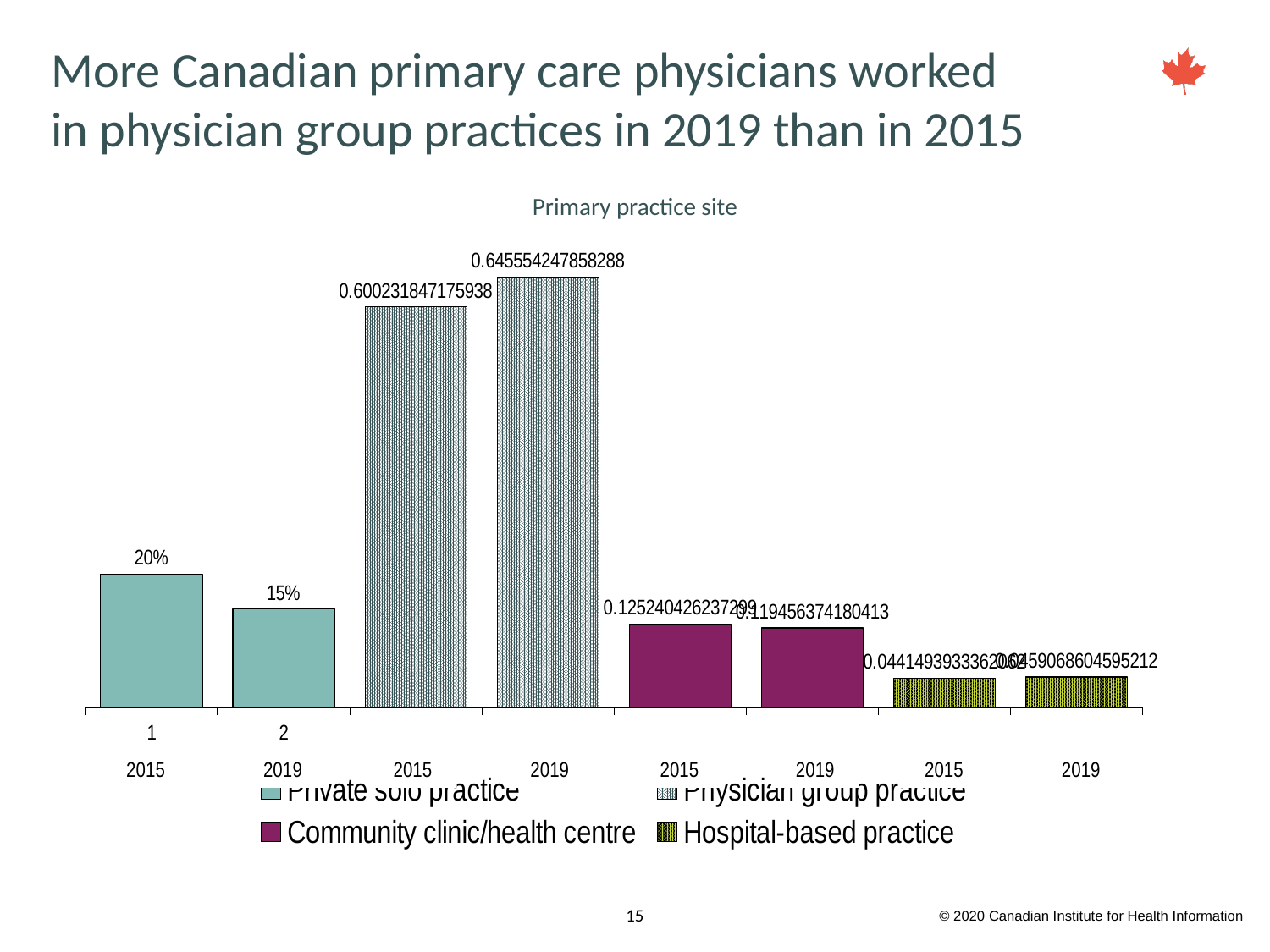
How many series does the legend list? 4 Which series has the shortest bars in the chart? Hospital-based practice What is the title of the chart? Primary practice site What is the value for Physician group practice in 2015? 0.600231847175938 Which is larger: Physician group practice in 2015 or Physician group practice in 2019? 2019 What is the value for Private solo practice in 2019? 15% What kind of chart is shown on the slide? bar chart What is the value for Private solo practice in 2015? 20% Which series has the tallest bar in the chart? Physician group practice What is the value for Physician group practice in 2019? 0.645554247858288 Did the value for Private solo practice rise or fall from 2015 to 2019? fall How many bars are plotted in the chart? 8